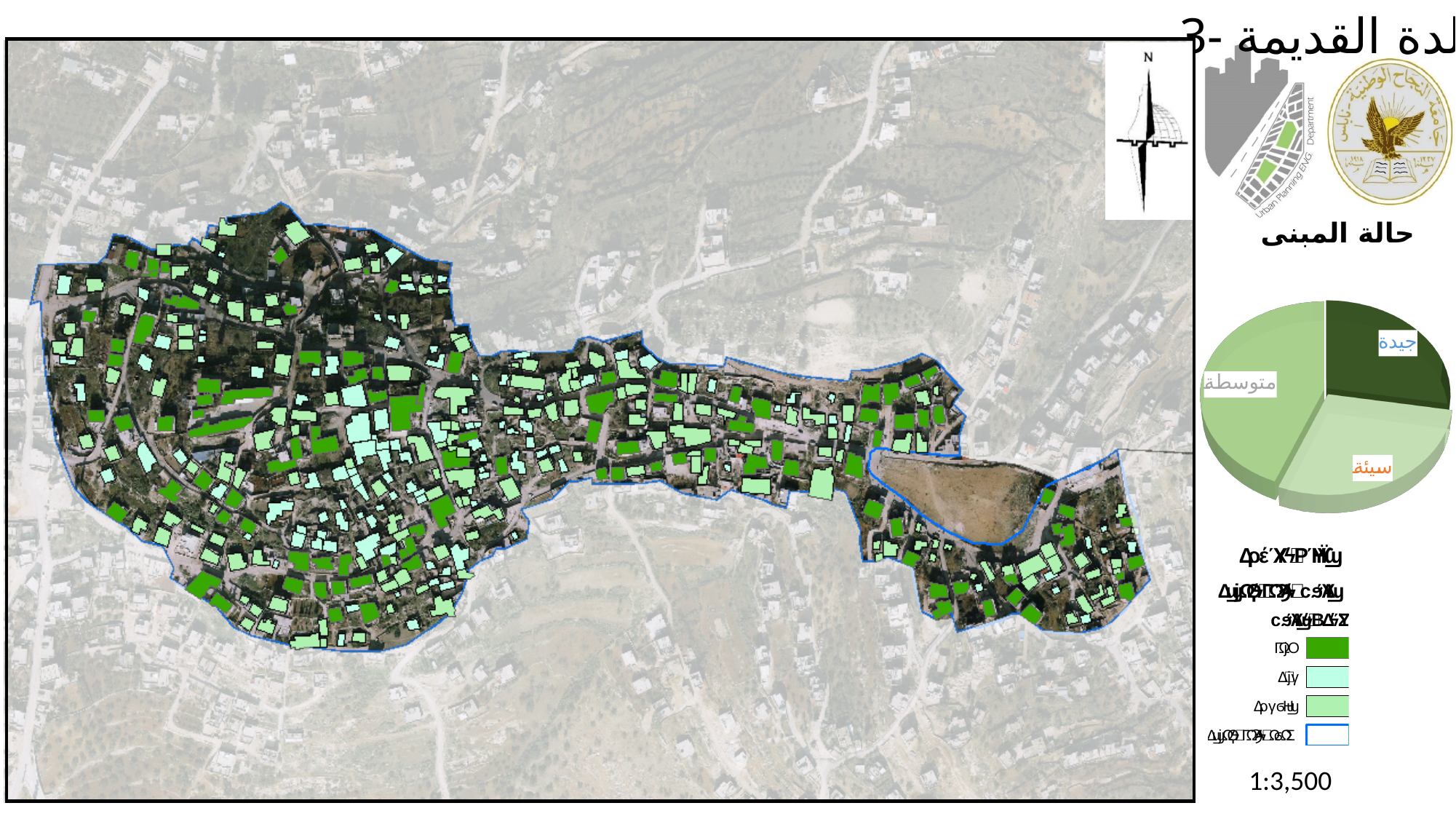
How many slices does the pie chart have? 3 Which slice is larger, متوسطة or جيدة? متوسطة Which slice is larger, متوسطة or سيئة? متوسطة What is the title of the pie chart? حالة المبنى Which slice of the pie chart is coloured dark green? جيدة What kind of chart is shown on the slide? pie chart Which category has the largest slice in the pie chart? متوسطة